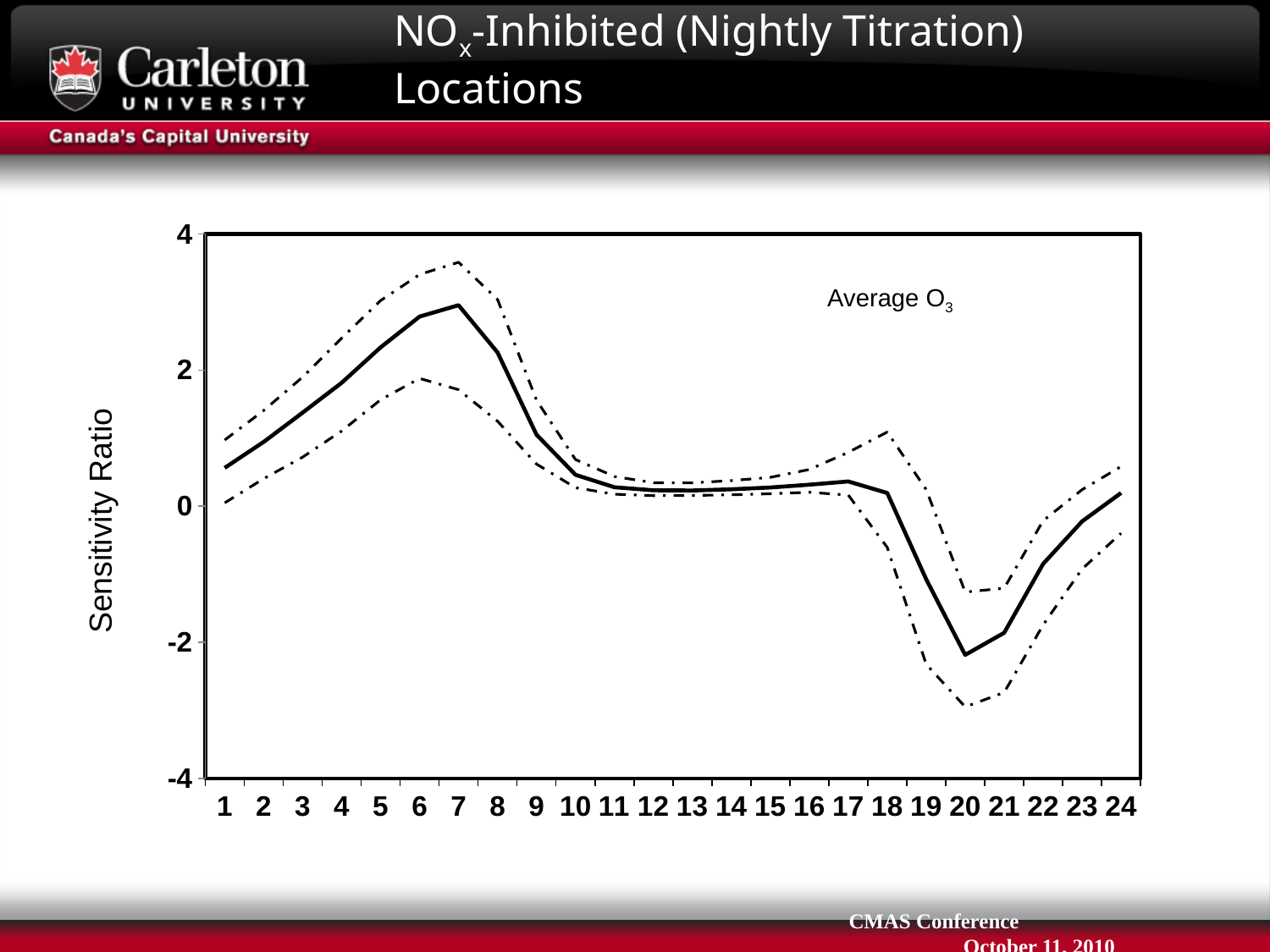
Is the value of the solid line at 7 greater or less than 2? greater What is the label of the y axis? Sensitivity Ratio At which x-axis value does the solid line reach its lowest point? 20 At which x-axis value does the solid line reach its highest point? 7 What type of chart is shown on the slide? Line chart Is the value of the solid line at 1 greater or less than 0? greater How many points are labelled along the x axis of the chart? 24 Does the solid line rise or fall between 20 and 24 on the x axis? rise Is the value of the solid line at 20 greater or less than -2? less Does the solid line rise or fall between 7 and 10 on the x axis? fall How many lines are plotted on the chart? 3 What text annotation appears inside the plot area? Average O3